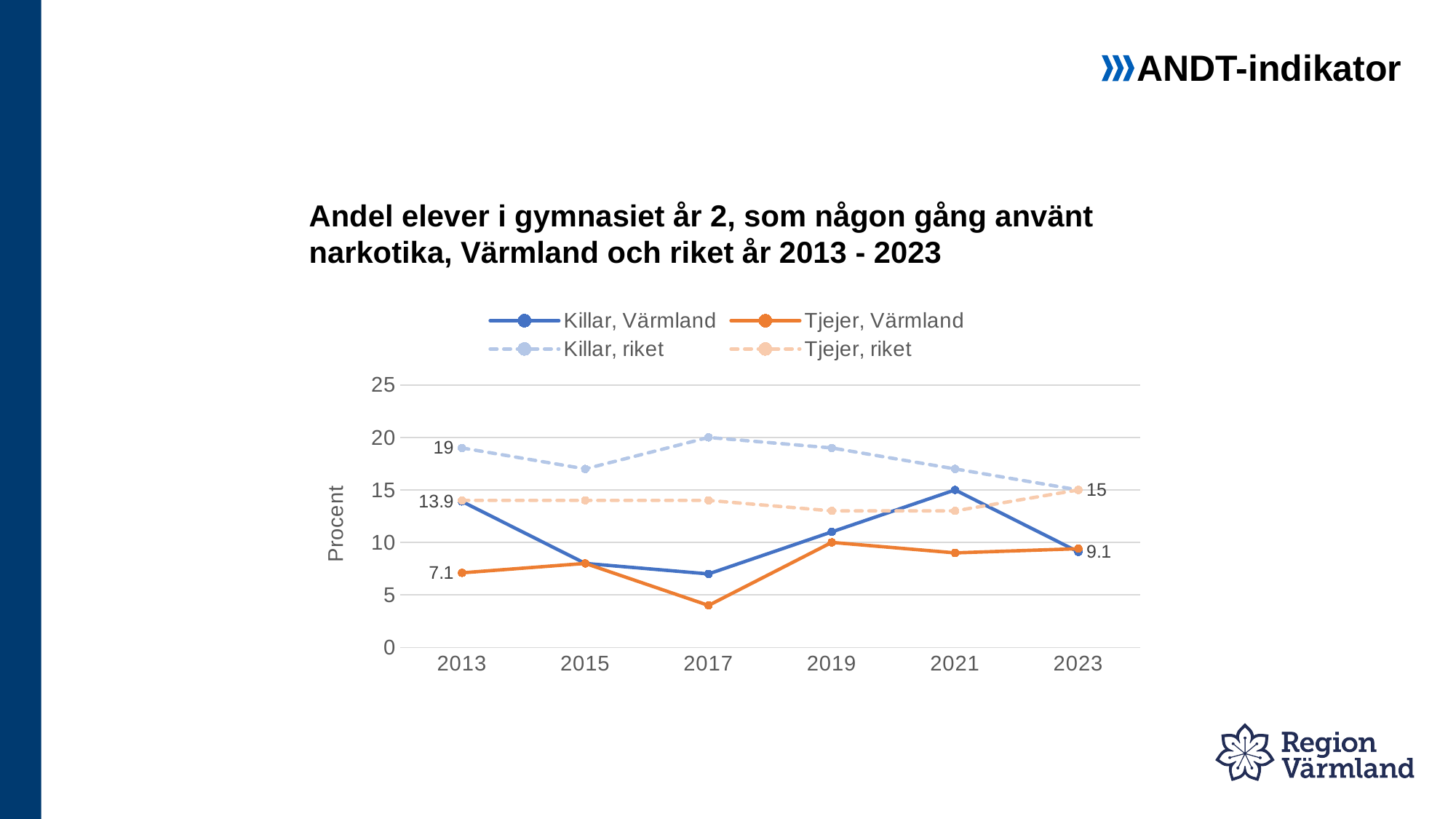
Is the value for Killar, riket in 2017 greater or less than 15? greater What kind of chart is shown on the slide? line chart Which series has the highest value in 2013? Killar, riket What is the value for Killar, riket in 2013? 19 How many years are shown on the x axis? 6 What is the difference between Killar, Värmland and Tjejer, Värmland in 2013? 6.8 What is the value for Killar, Värmland in 2013? 13.9 In which year is Tjejer, Värmland at its lowest? 2017 Is the value for Tjejer, Värmland in 2017 greater or less than 5? less What is the value for Tjejer, Värmland in 2013? 7.1 How many series does the legend list? 4 What is the label on the y axis? Procent